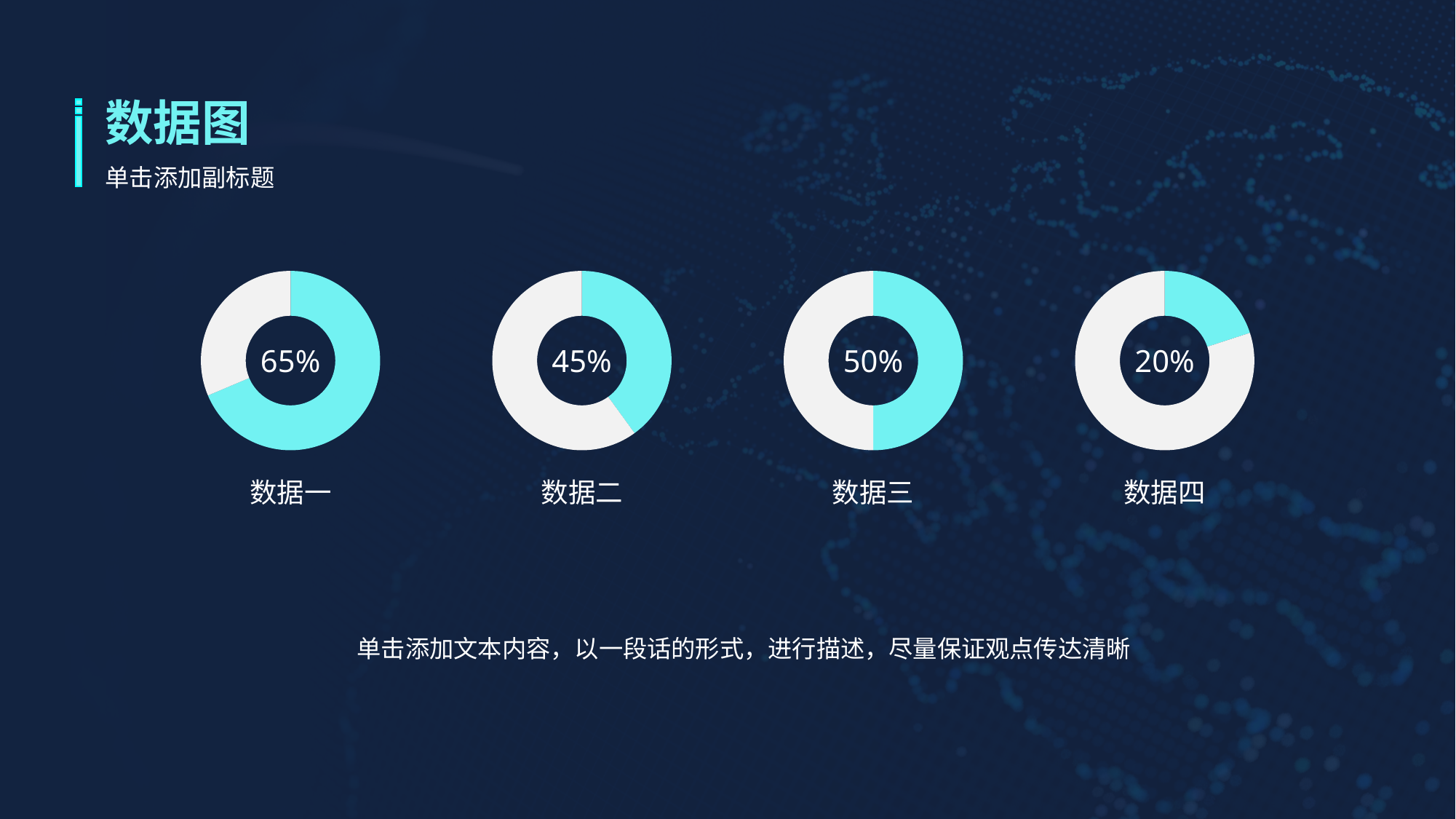
Which of the four donut charts shows the lowest percentage? 数据四 What is the title of the slide containing the four donut charts? 数据图 What is the difference between the percentages shown for 数据一 and 数据四? 45% Which of the four donut charts shows the highest percentage? 数据一 What percentage is shown in the donut chart labelled 数据二? 45% What percentage is shown in the donut chart labelled 数据三? 50% What percentage is shown in the donut chart labelled 数据一? 65% What percentage is shown in the donut chart labelled 数据四? 20% Which shows a larger percentage, 数据二 or 数据三? 数据三 What kind of chart is used for 数据一, 数据二, 数据三 and 数据四? Donut chart What is the difference between the percentages shown for 数据三 and 数据二? 5% How many donut charts are on the slide? 4